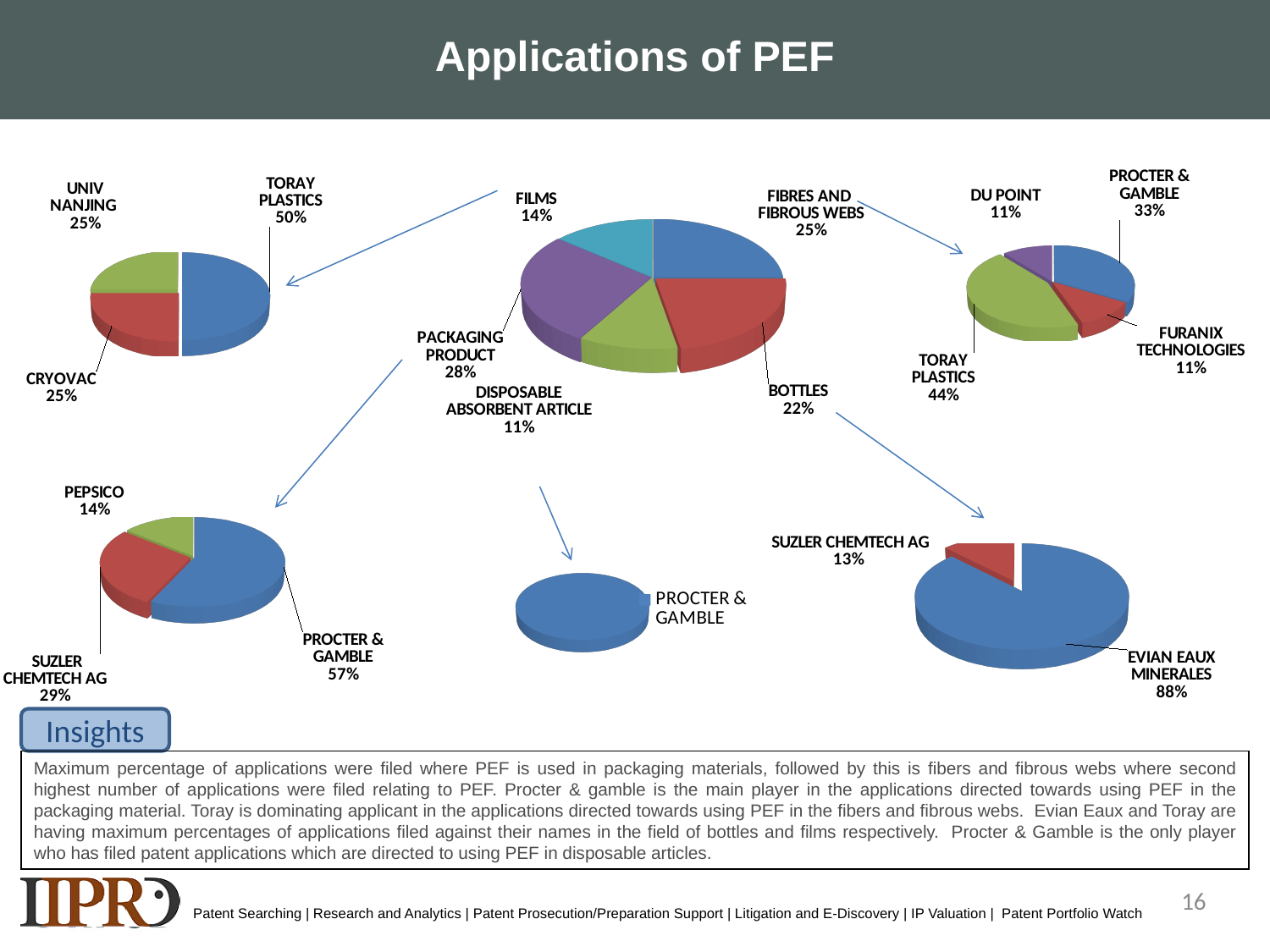
In the top-right pie chart, which applicant has the largest share? Toray Plastics In the central pie chart, what percentage is shown for Packaging Product? 28% In the bottom-left pie chart, which is larger, the share for Procter & Gamble or the share for Suzler Chemtech AG? Procter & Gamble What type of chart is used on this slide? Pie chart In the central pie chart, which category has the smallest share? Disposable Absorbent Article In the bottom-left pie chart, what is the difference between the shares for Procter & Gamble and Pepsico? 43% In the top-right pie chart, what percentage is shown for Procter & Gamble? 33% In the top-left pie chart, what percentage is shown for Toray Plastics? 50% In the central pie chart, which category has the largest share? Packaging Product In the bottom-right pie chart, what percentage is shown for Evian Eaux Minerales? 88% In the central pie chart, what is the difference between the shares for Fibres and Fibrous Webs and Bottles? 3% How many categories does the central pie chart show? 5